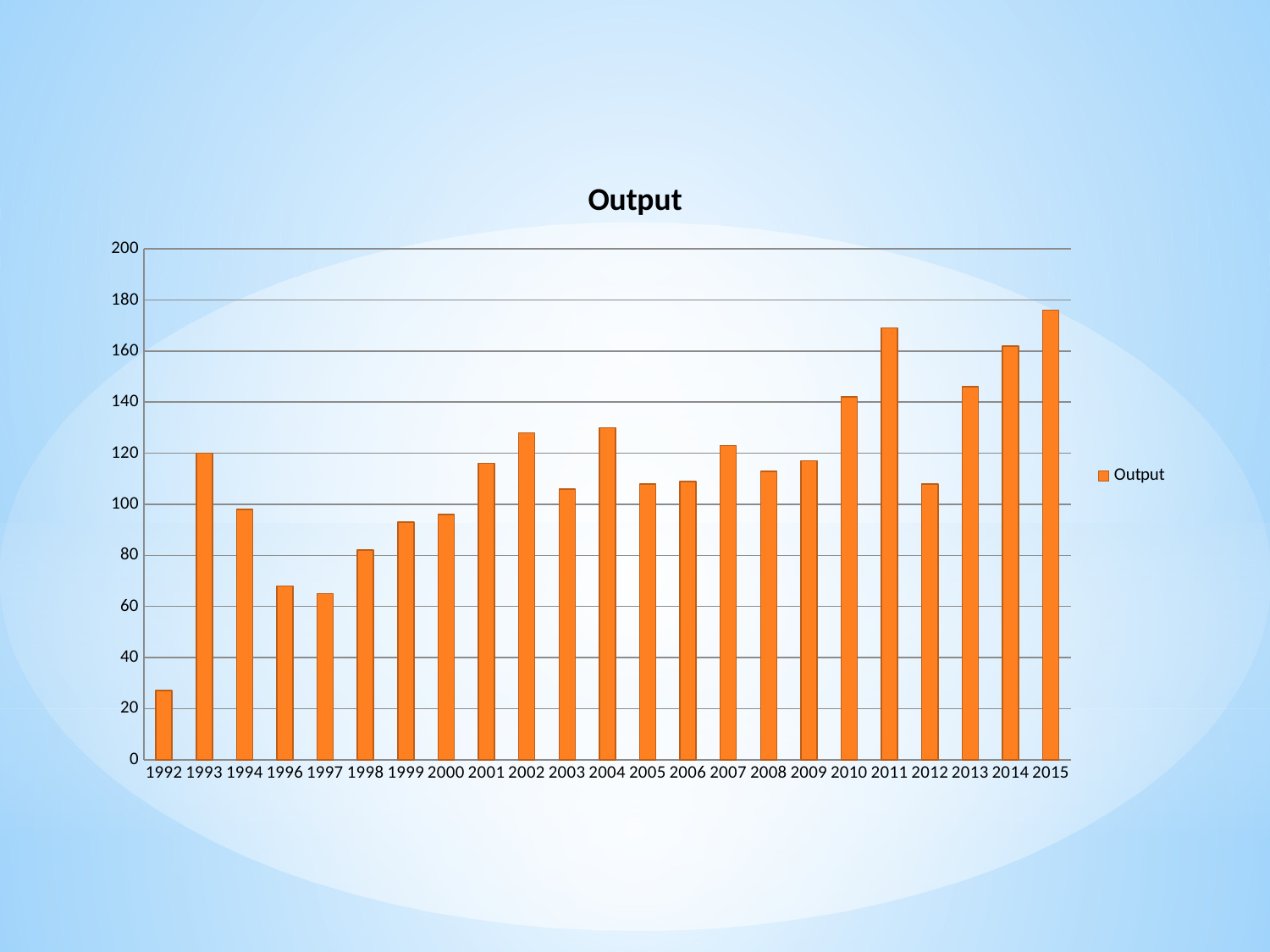
Which year has the highest Output? 2015 How many years are shown on the x axis? 23 What is the title of the chart? Output Is the value for 1999 greater or less than 100? less Is the value for 2011 greater or less than 160? greater Which is larger, the Output for 2011 or for 2012? 2011 Which year has the lowest Output? 1992 What kind of chart is shown on the slide? bar chart How many series does the legend list? 1 Is the value for 1992 greater or less than 40? less Which is larger, the Output for 1993 or for 1994? 1993